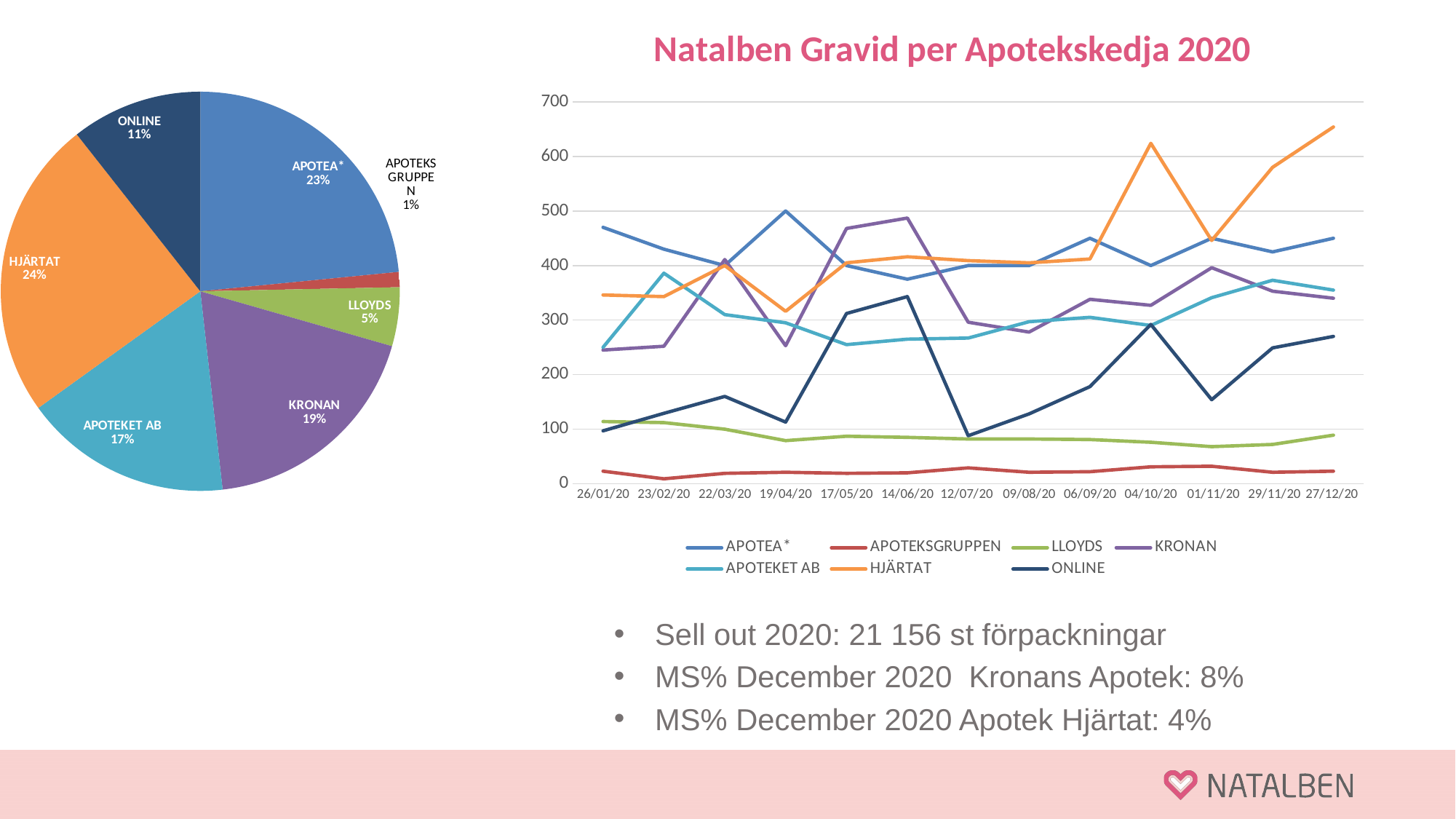
In the chart titled 'Natalben Gravid per Apotekskedja 2020', how many dates are shown on the x axis? 13 In the pie chart on the left, what share does KRONAN have? 19% In the pie chart on the left, which slice is the smallest? APOTEKSGRUPPEN In the chart titled 'Natalben Gravid per Apotekskedja 2020', which series has the highest value at 27/12/20? HJÄRTAT In the chart titled 'Natalben Gravid per Apotekskedja 2020', is the value for HJÄRTAT at 27/12/20 greater or less than 600? greater In the pie chart on the left, what is the difference in percentage points between APOTEA* and APOTEKET AB? 6 In the pie chart on the left, what share does HJÄRTAT have? 24% In the chart titled 'Natalben Gravid per Apotekskedja 2020', how many series does the legend list? 7 How many slices does the pie chart on the left have? 7 What kind of chart is 'Natalben Gravid per Apotekskedja 2020'? line chart In the pie chart on the left, which is larger, ONLINE or LLOYDS? ONLINE In the pie chart on the left, which slice is the largest? HJÄRTAT